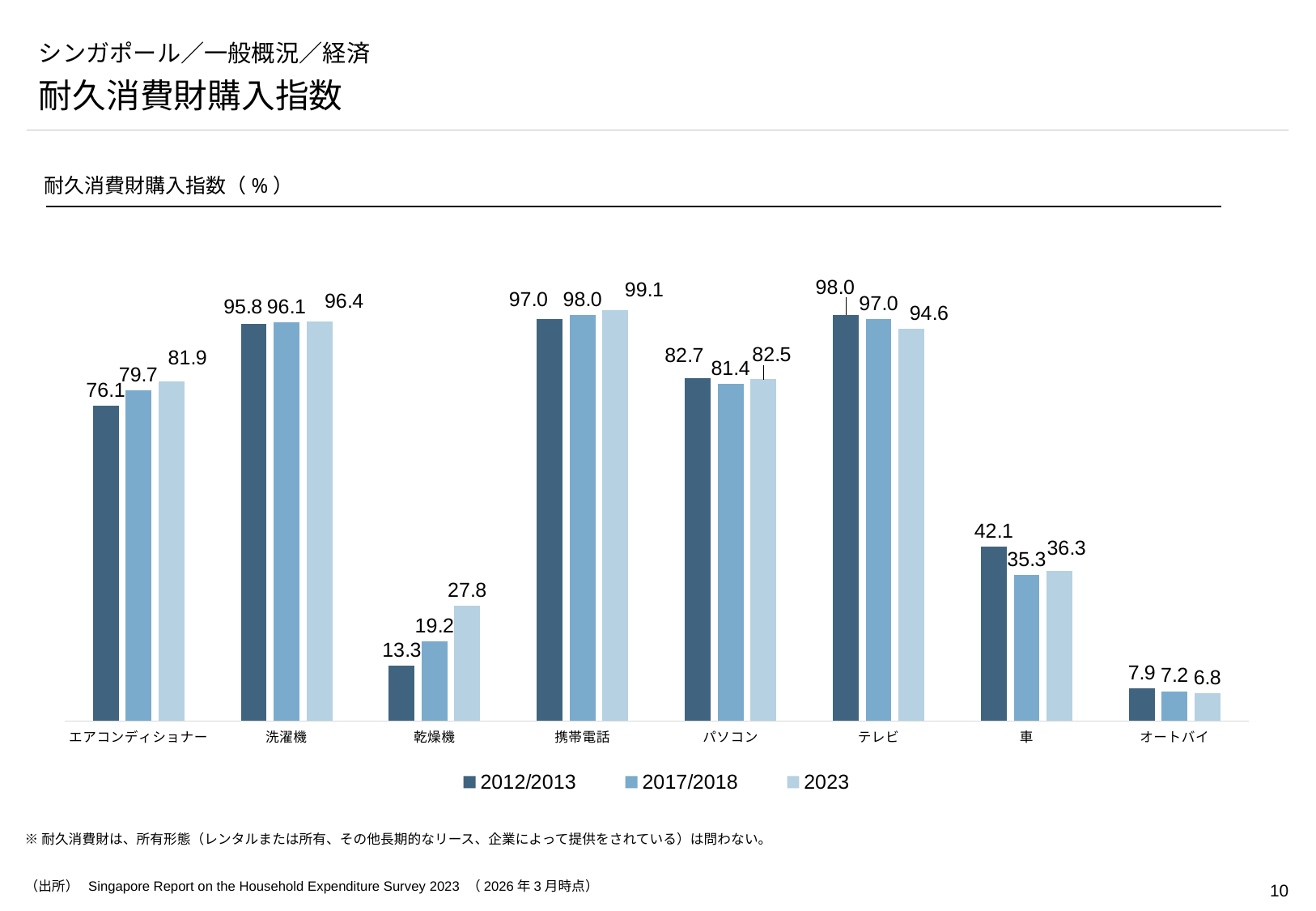
What is the difference between the 2023 and 2012/2013 values for 乾燥機? 14.5 How many categories are shown on the x axis? 8 Which is larger: the 2012/2013 value for テレビ or the 2012/2013 value for 携帯電話? テレビ How many series does the legend list? 3 What is the difference between the 2012/2013 and 2017/2018 values for 車? 6.8 What is the 2012/2013 value for 車? 42.1 What kind of chart is shown on the slide? Bar chart Which category has the highest 2023 value? 携帯電話 Which category has the lowest 2012/2013 value? オートバイ What is the 2017/2018 value for パソコン? 81.4 What is the 2023 value for 乾燥機? 27.8 Do the values for オートバイ rise or fall from 2012/2013 to 2023? Fall